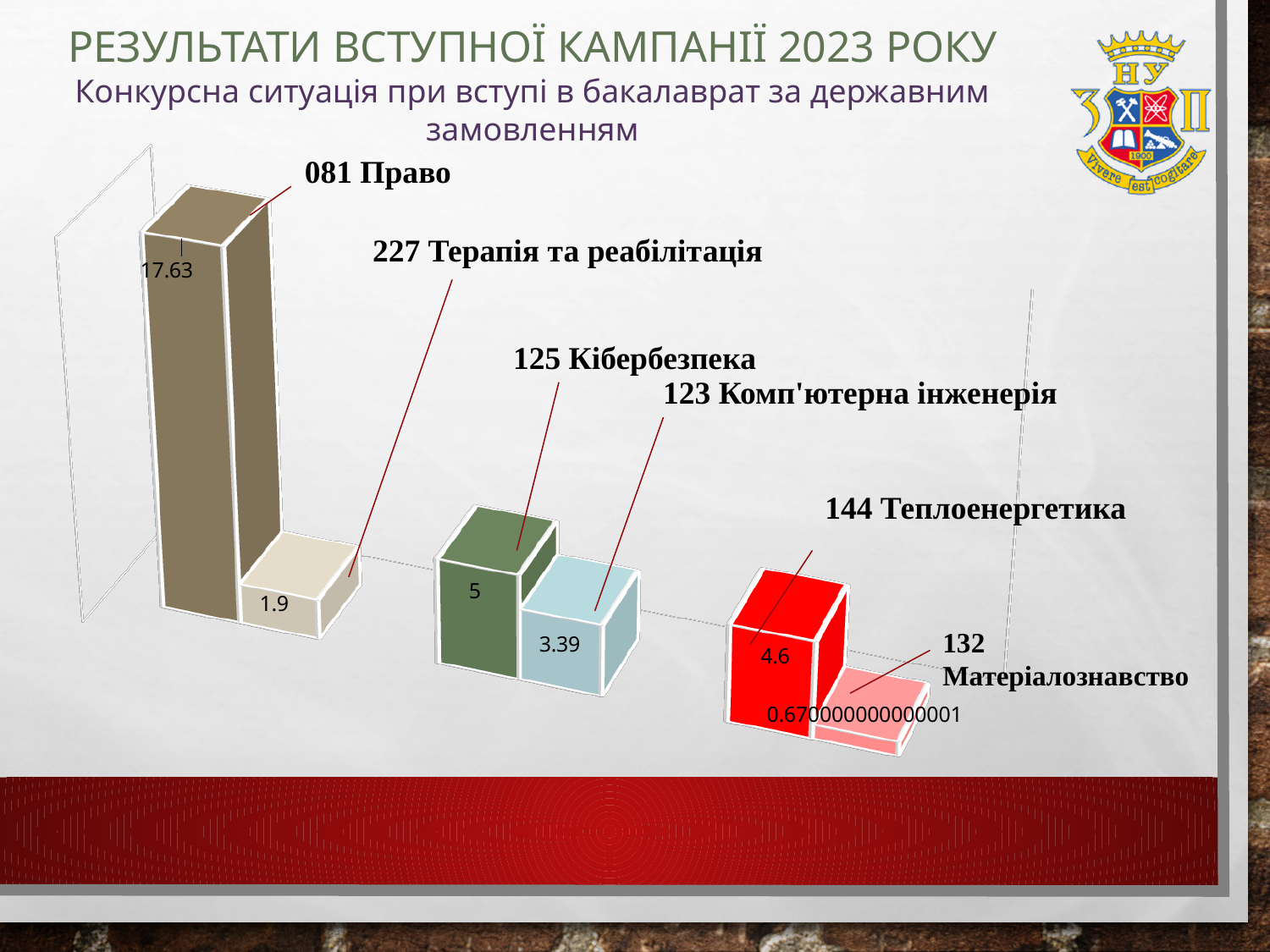
Which has a larger value, 125 Кібербезпека or 144 Теплоенергетика? 125 Кібербезпека What is the value shown for 144 Теплоенергетика? 4.6 What kind of chart is shown on the slide? Bar chart Which program has the lowest value on the chart? 132 Матеріалознавство How many programs (bars) are shown on the chart? 6 What is the difference between the values for 081 Право and 227 Терапія та реабілітація? 15.73 What is the value shown for 123 Комп'ютерна інженерія? 3.39 What is the value shown for 125 Кібербезпека? 5 What value is printed on the bar for 132 Матеріалознавство? 0.670000000000001 What is the value shown for 081 Право? 17.63 Which program has the highest value on the chart? 081 Право What is the value shown for 227 Терапія та реабілітація? 1.9